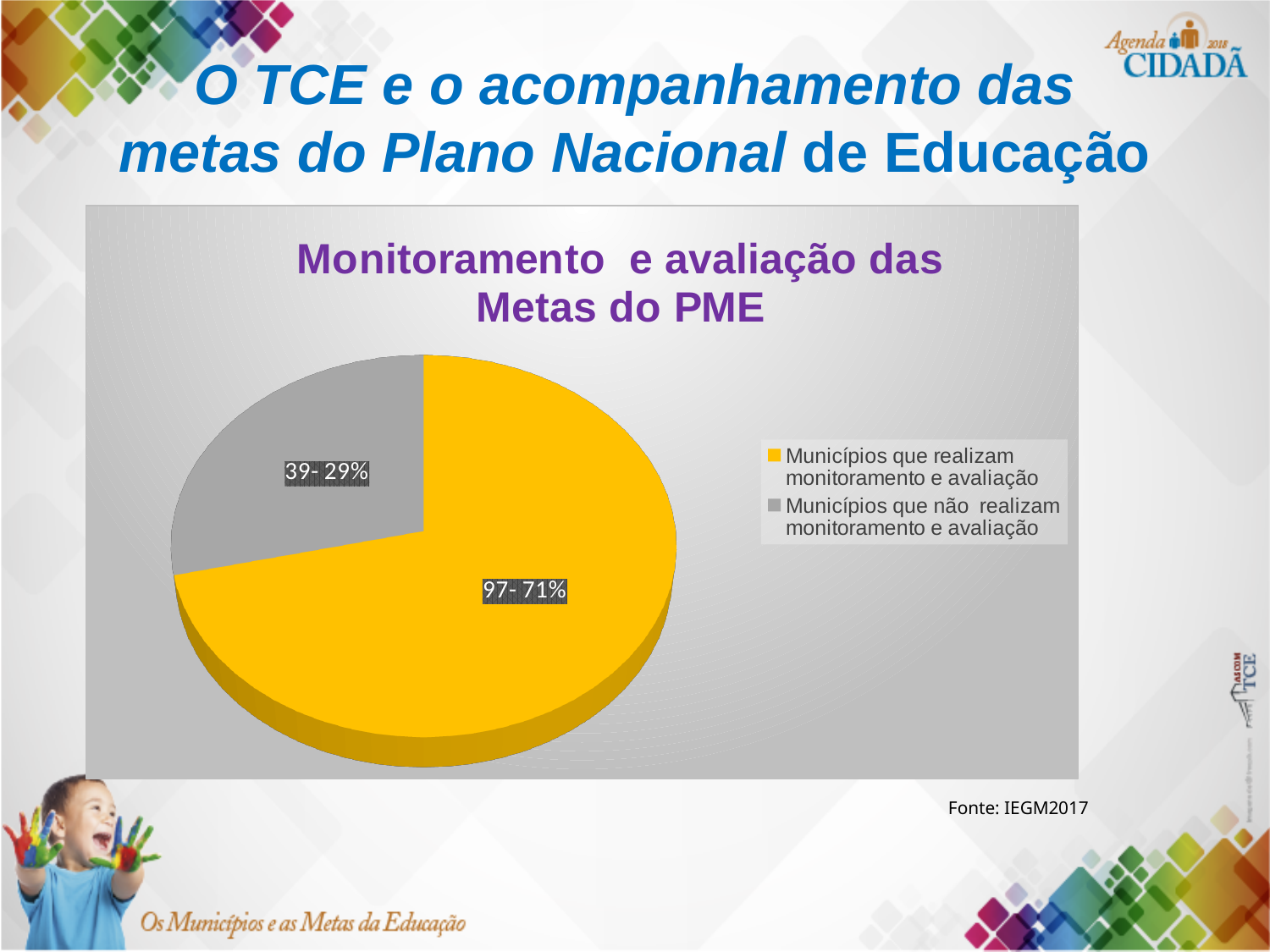
Which slice is the largest in the pie chart? Municípios que realizam monitoramento e avaliação Which slice is the smallest in the pie chart? Municípios que não realizam monitoramento e avaliação How many entries does the legend list? 2 What is the difference in the number of municipalities between those that do and those that do not carry out monitoring and evaluation (97 vs 39)? 58 What is the title of the chart? Monitoramento e avaliação das Metas do PME What percentage share of the pie is 'Municípios que não realizam monitoramento e avaliação'? 29% How many slices does the pie chart have? 2 What is the data label shown on the slice for 'Municípios que realizam monitoramento e avaliação'? 97- 71% Which colour represents 'Municípios que não realizam monitoramento e avaliação' in the pie chart? grey What percentage share of the pie is 'Municípios que realizam monitoramento e avaliação'? 71% What is the data label shown on the slice for 'Municípios que não realizam monitoramento e avaliação'? 39- 29% What kind of chart is shown on the slide? pie chart